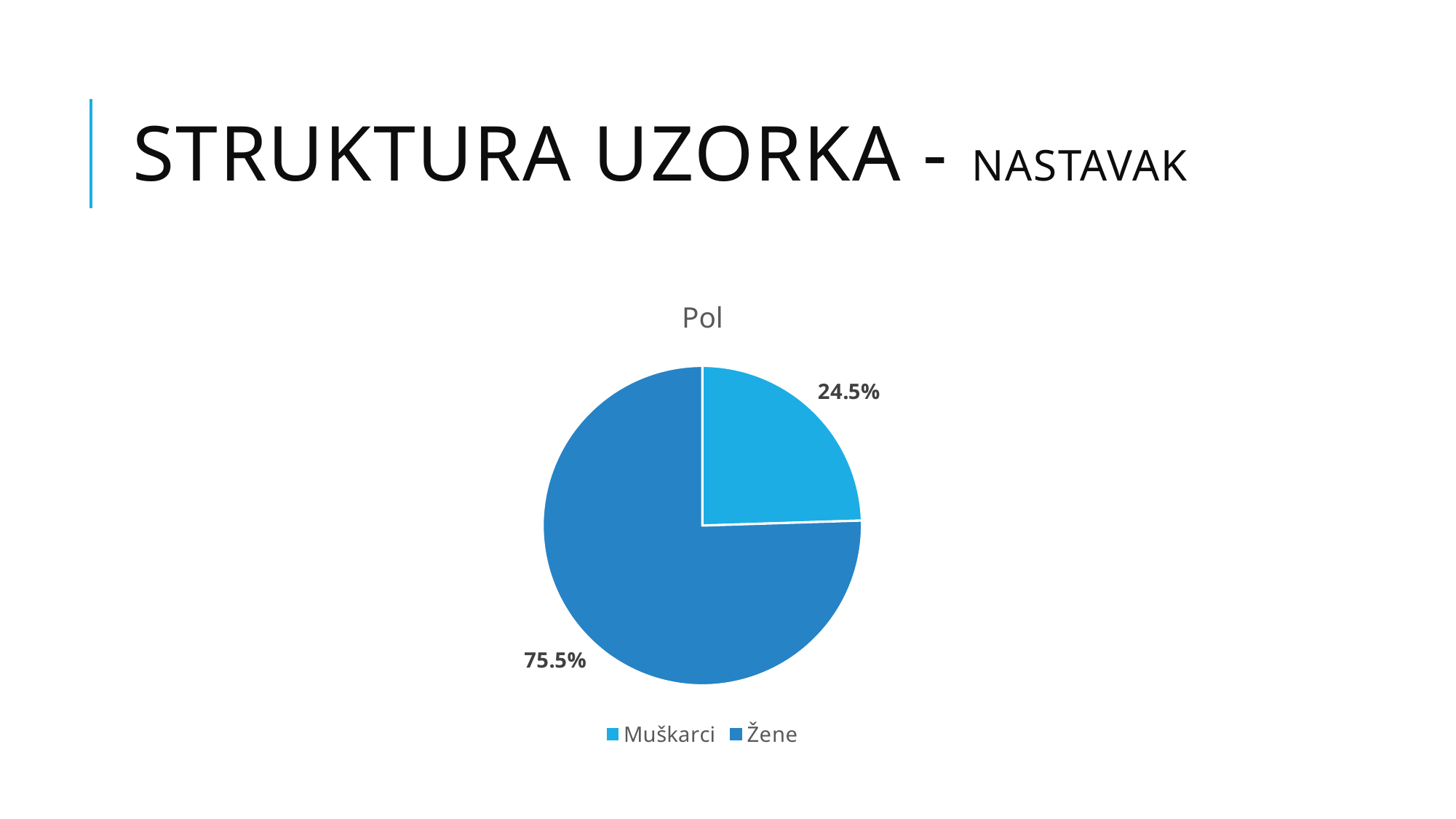
What share of the pie does Žene represent? 75.5% Which slice is larger, Muškarci or Žene? Žene Which category has the largest slice of the pie? Žene Which legend entry is shown in the lighter blue colour? Muškarci How many categories does the pie chart show? 2 What kind of chart is shown on the slide? pie chart What share of the pie does Muškarci represent? 24.5% Is the share for Muškarci greater or less than 50%? less What is the title of the chart? Pol What is the difference in percentage points between the Žene and Muškarci slices? 51 percentage points Which category has the smallest slice of the pie? Muškarci How many entries does the legend list? 2